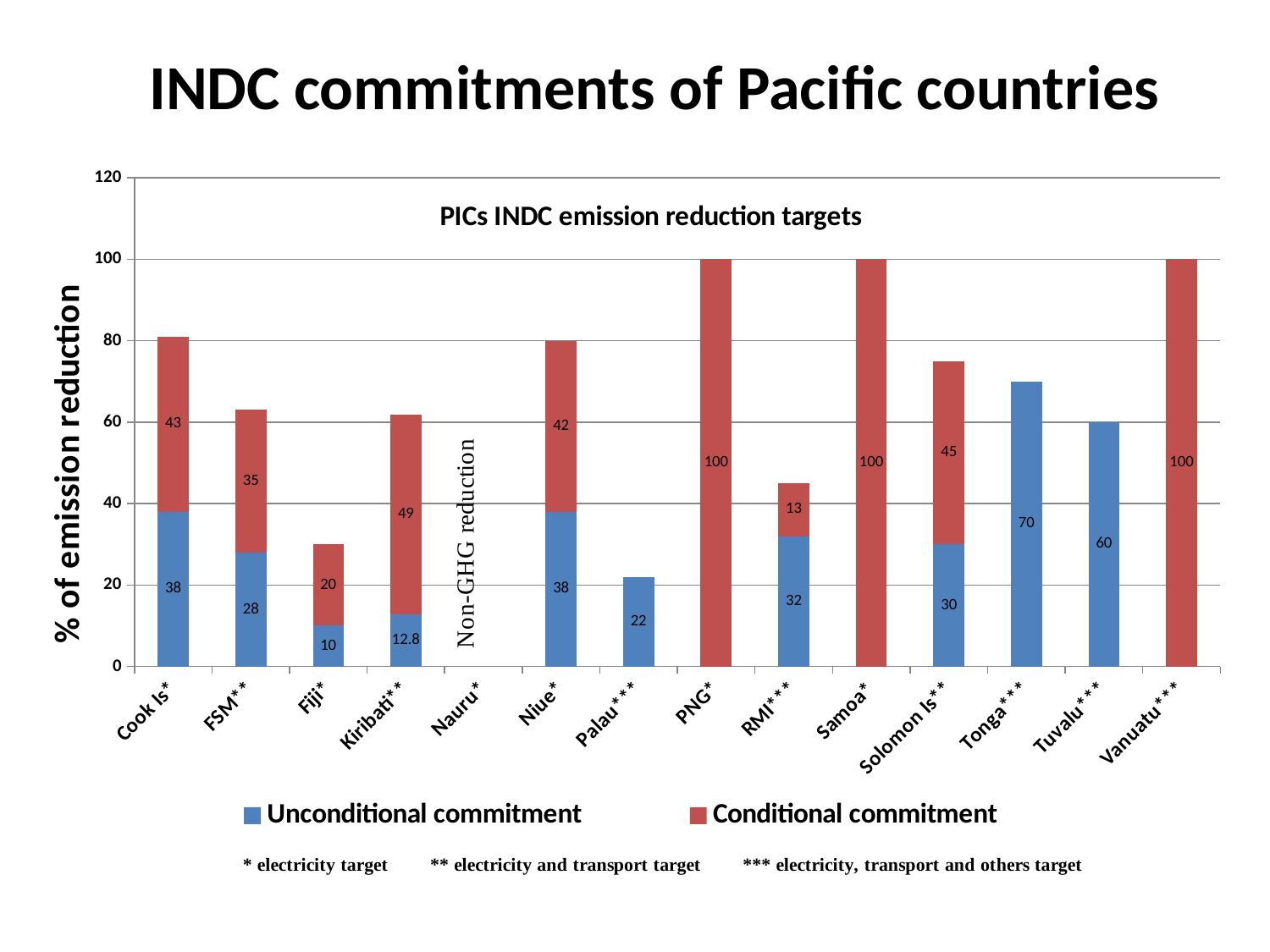
What text is shown in place of a bar for Nauru*? Non-GHG reduction What is the total of the stacked bar for Fiji*? 30 What is the Unconditional commitment value for Cook Is*? 38 Which is larger, the Unconditional commitment for Tuvalu*** or for Palau***? Tuvalu*** What is the total of the stacked bar for Solomon Is**? 75 What is the Conditional commitment value for Kiribati**? 49 Which country has the highest Unconditional commitment value? Tonga*** What is the Unconditional commitment value for Tonga***? 70 What is the difference between the Conditional commitment values for Niue* and FSM**? 7 What is the Conditional commitment value for RMI***? 13 How many series does the legend list? 2 What type of chart is shown on the slide? Stacked bar chart